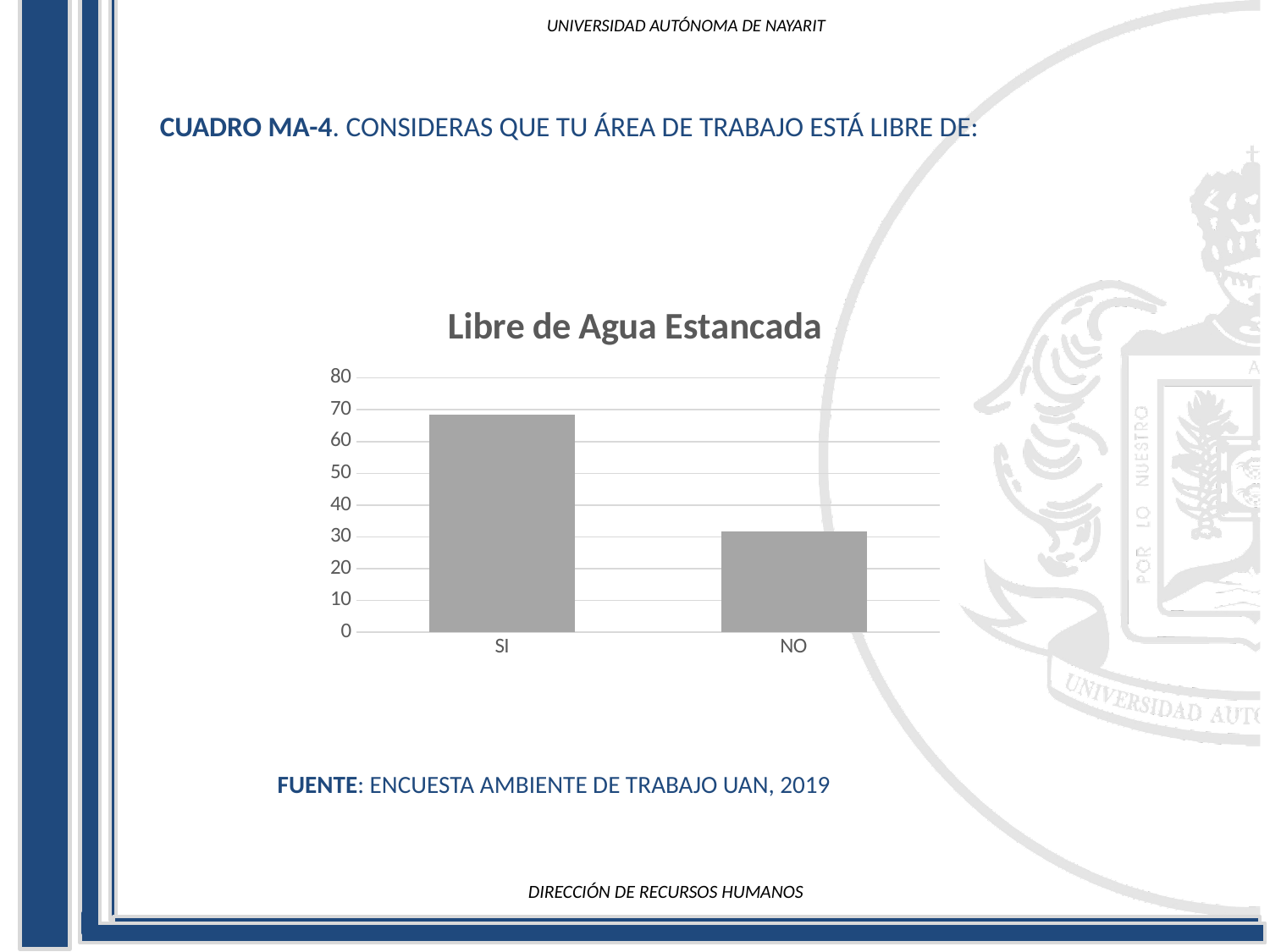
What is the title of the chart? Libre de Agua Estancada Is the value for NO greater or less than 40? less Is the value for NO greater or less than 20? greater What is the highest value shown on the vertical axis of the chart? 80 Which category has the lowest value in the chart? NO Is the value for SI greater or less than 60? greater How many categories are shown on the x axis of the chart? 2 Do the values rise or fall from SI to NO along the x axis? fall Which is larger, the value for SI or the value for NO? SI What kind of chart is shown on the slide? bar chart Which category has the highest value in the chart? SI